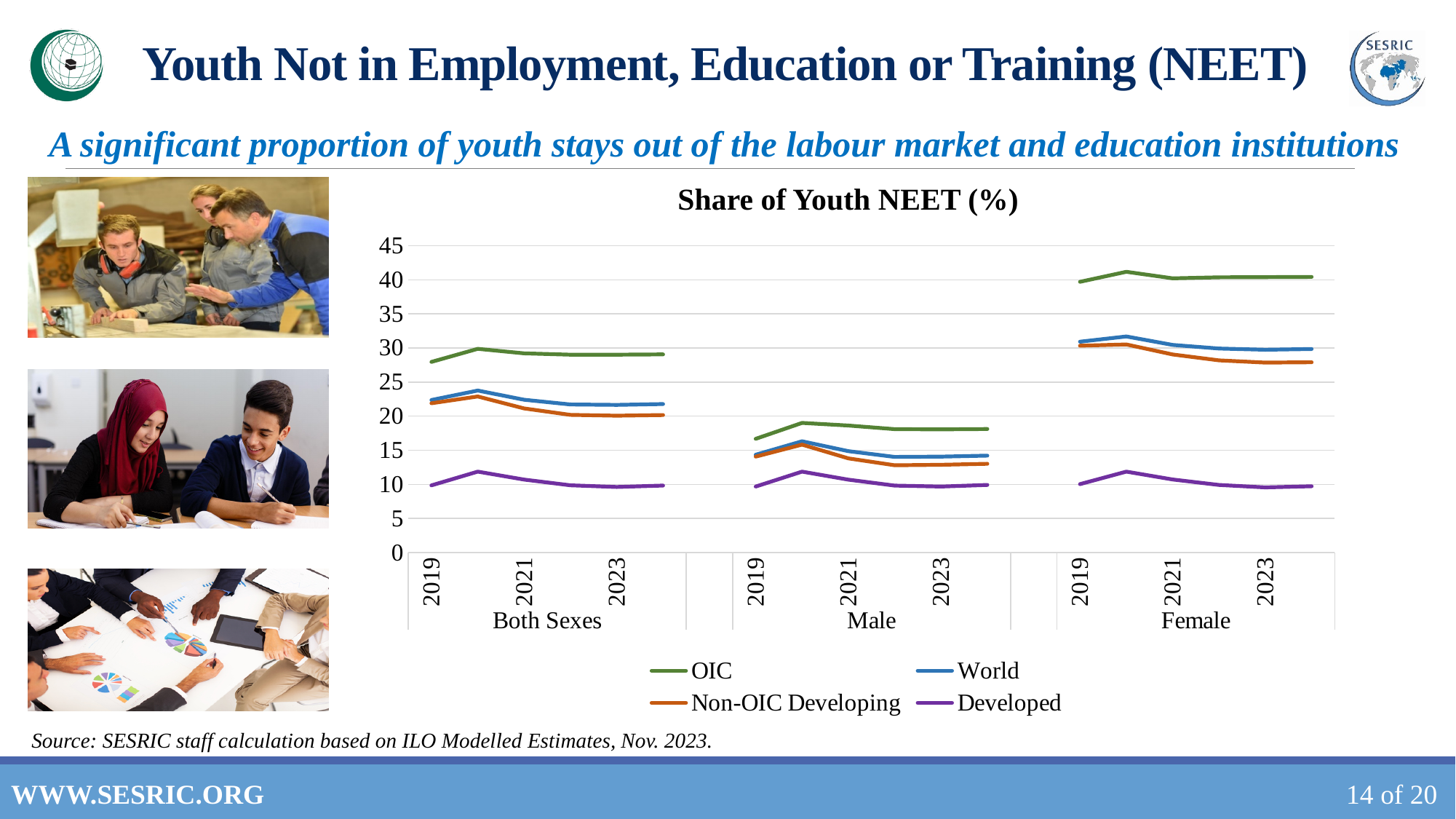
Which is larger in 2023: the OIC value for Female or the OIC value for Male? Female What kind of chart is shown on the slide? Line chart How many groups (sex categories) are shown along the x axis of the chart? 3 Is the value for World in the Both Sexes group in 2019 greater or less than 20? greater Is the value for OIC in the Female group in 2019 greater or less than 35? greater Does the Non-OIC Developing line in the Female group rise or fall from 2020 to 2023? Fall What is the title of the chart? Share of Youth NEET (%) Which series has the lowest values in the Both Sexes group? Developed Is the value for OIC in the Male group in 2023 greater or less than 15? greater How many series does the legend of the chart list? 4 Which series has the highest values in the Female group? OIC